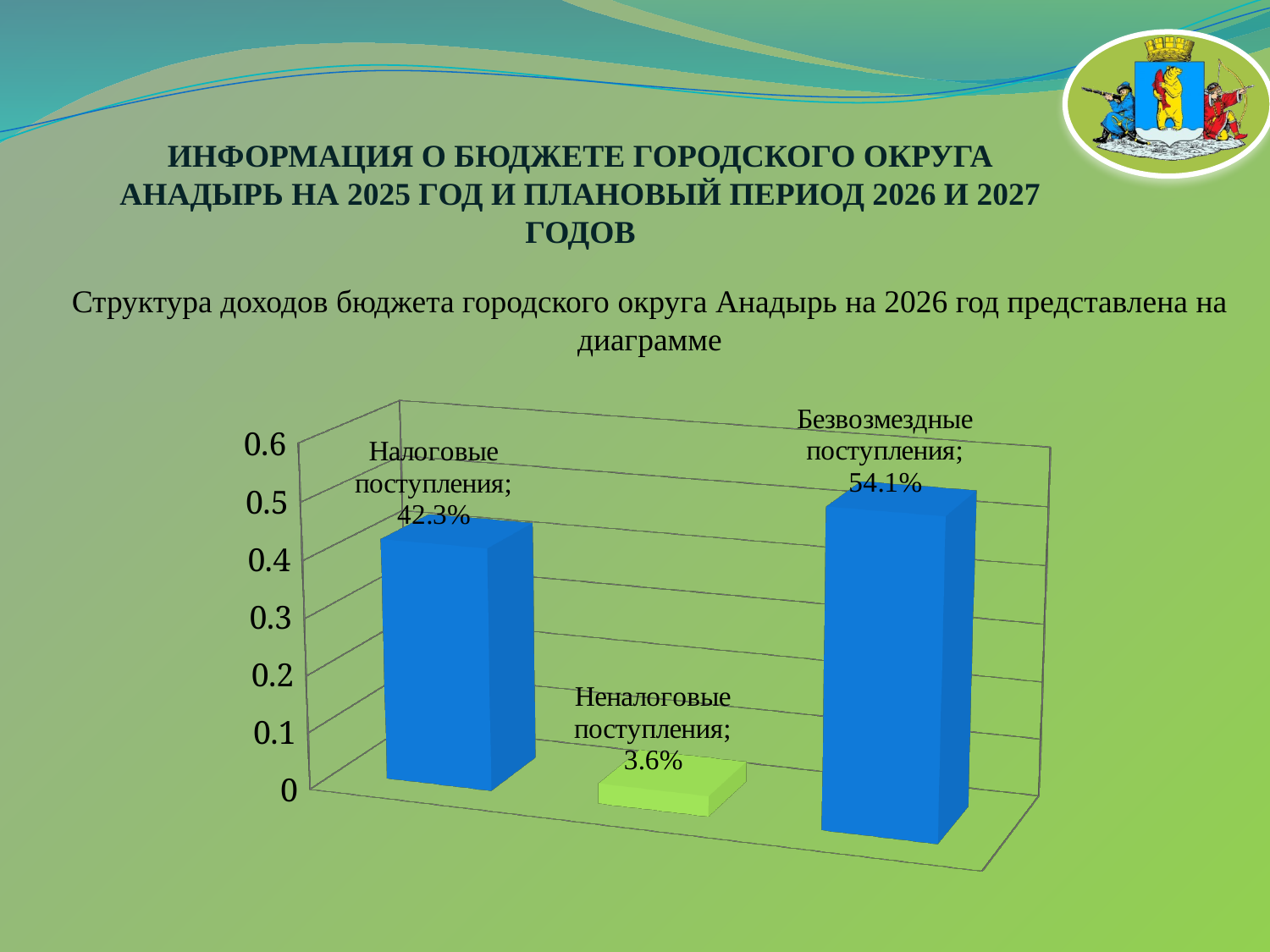
What is the value shown for Неналоговые поступления? 3.6% What is the difference between Налоговые поступления and Неналоговые поступления? 38.7% How many categories are shown in the chart? 3 Which is larger, Налоговые поступления or Безвозмездные поступления? Безвозмездные поступления Which category has the highest value? Безвозмездные поступления Which category has the lowest value? Неналоговые поступления What kind of chart is shown on the slide? bar chart What is the difference between Безвозмездные поступления and Налоговые поступления? 11.8% Is the value for Налоговые поступления greater or less than 0.5? less What is the highest value shown on the vertical axis? 0.6 What is the value shown for Налоговые поступления? 42.3% What is the value shown for Безвозмездные поступления? 54.1%